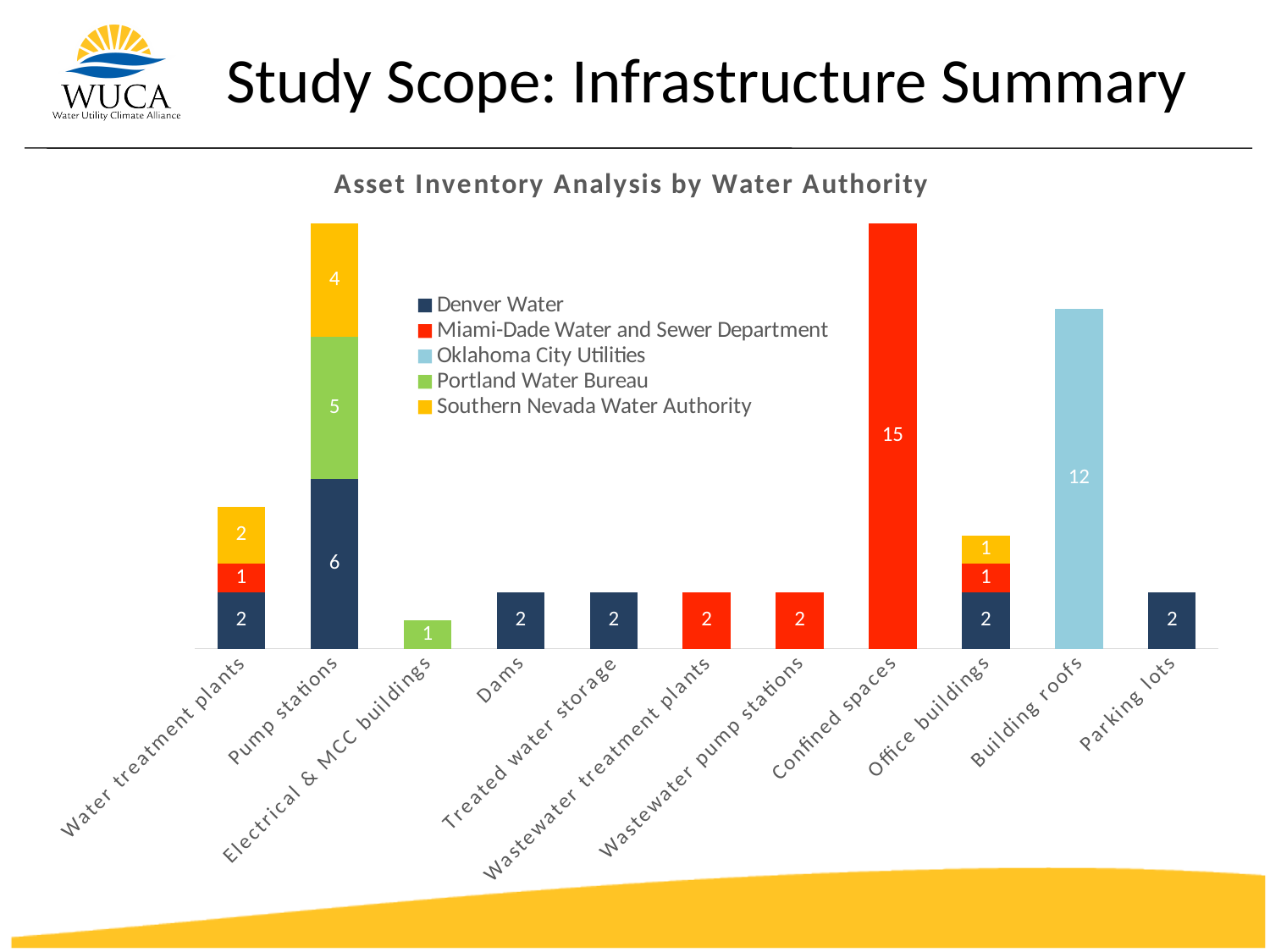
What is the total of the stacked bar for Office buildings? 4 What is the title of the chart? Asset Inventory Analysis by Water Authority What is the total of the stacked bar for Pump stations? 15 What is the value for Oklahoma City Utilities in the Building roofs category? 12 What type of chart is shown on the slide? stacked bar chart What is the total of the stacked bar for Water treatment plants? 5 In which category does Denver Water have its highest value? Pump stations How many series does the legend list? 5 How many categories are shown on the x axis? 11 What is the value for Miami-Dade Water and Sewer Department in the Confined spaces category? 15 What is the value for Portland Water Bureau in the Pump stations category? 5 Which category has the lowest total value? Electrical & MCC buildings